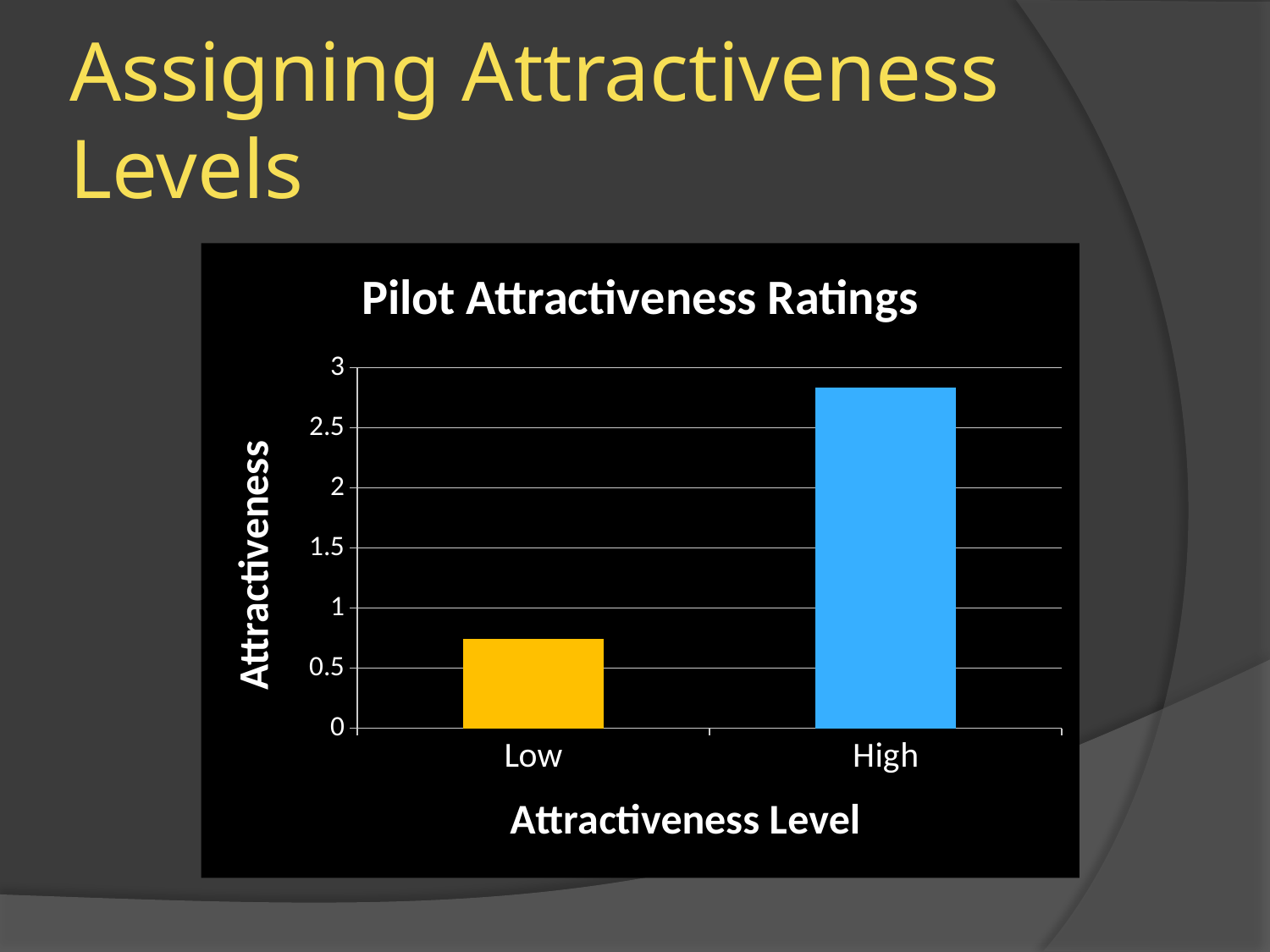
Do the values rise or fall moving from Low to High along the x axis? rise Is the value for Low greater or less than 0.5? greater What is the label on the y axis of the chart? Attractiveness What kind of chart is shown on the slide? bar chart Which attractiveness level has the lowest bar? Low Is the value for High greater or less than 3? less What is the title of the chart? Pilot Attractiveness Ratings Which bar is taller, Low or High? High Which attractiveness level has the highest bar? High Is the value for Low greater or less than 1? less How many categories are shown on the x axis of the Pilot Attractiveness Ratings chart? 2